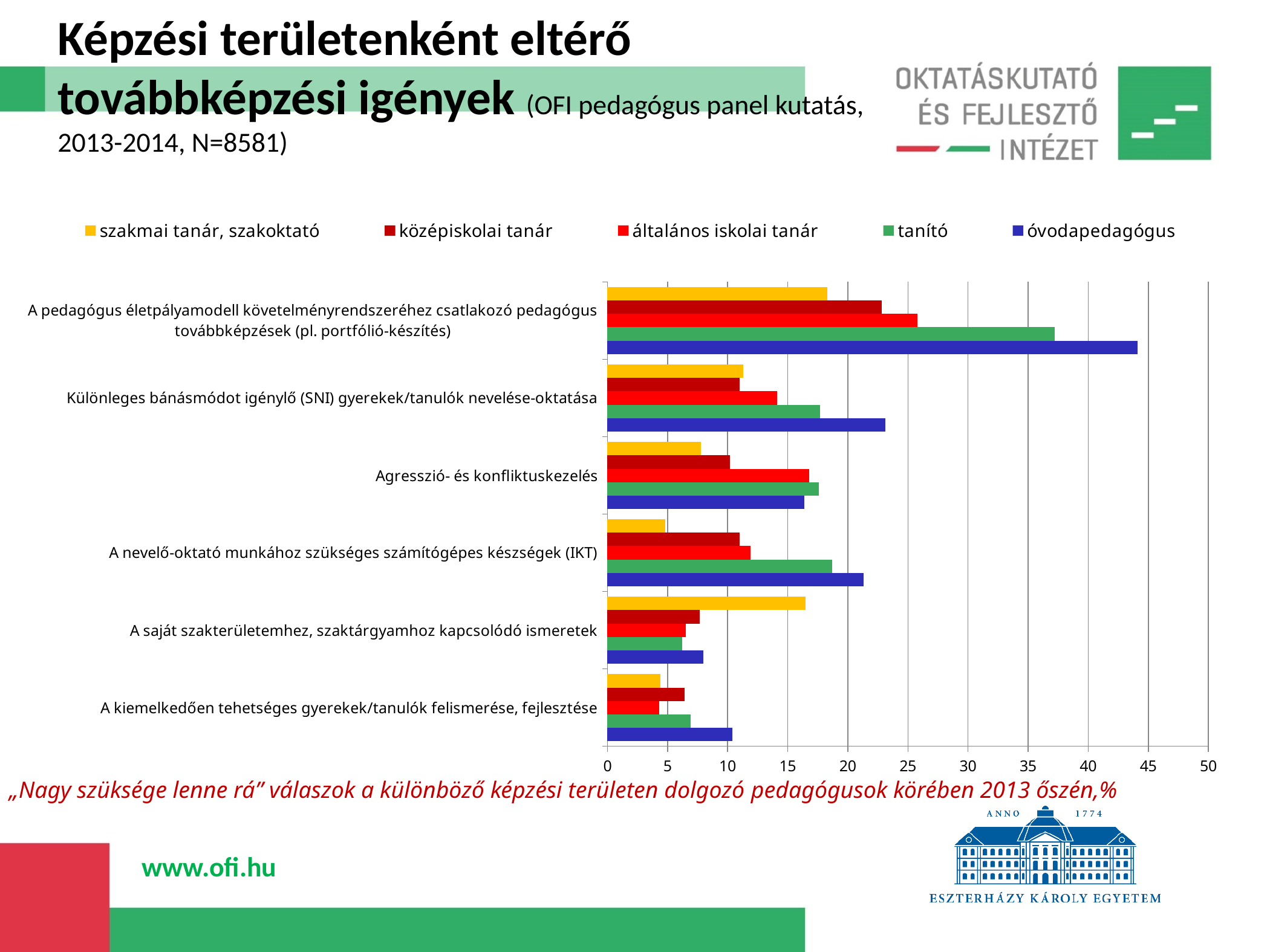
Is the tanító value for 'A pedagógus életpályamodell követelményrendszeréhez csatlakozó pedagógus továbbképzések' greater or less than 35? greater Is the óvodapedagógus value for 'Különleges bánásmódot igénylő (SNI) gyerekek/tanulók nevelése-oktatása' greater or less than 20? greater How many series does the legend list? 5 How many training-need categories are plotted on the y axis? 6 Which category has the lowest óvodapedagógus value? A saját szakterületemhez, szaktárgyamhoz kapcsolódó ismeretek For 'Agresszió- és konfliktuskezelés', which is larger: szakmai tanár, szakoktató or középiskolai tanár? középiskolai tanár Is the szakmai tanár, szakoktató value for 'A nevelő-oktató munkához szükséges számítógépes készségek (IKT)' greater or less than 10? less For 'A saját szakterületemhez, szaktárgyamhoz kapcsolódó ismeretek', which is larger: szakmai tanár, szakoktató or óvodapedagógus? szakmai tanár, szakoktató What colour represents the óvodapedagógus series in the legend? blue What kind of chart is shown on the slide? bar chart For 'A pedagógus életpályamodell követelményrendszeréhez csatlakozó pedagógus továbbképzések', which series has the highest value? óvodapedagógus